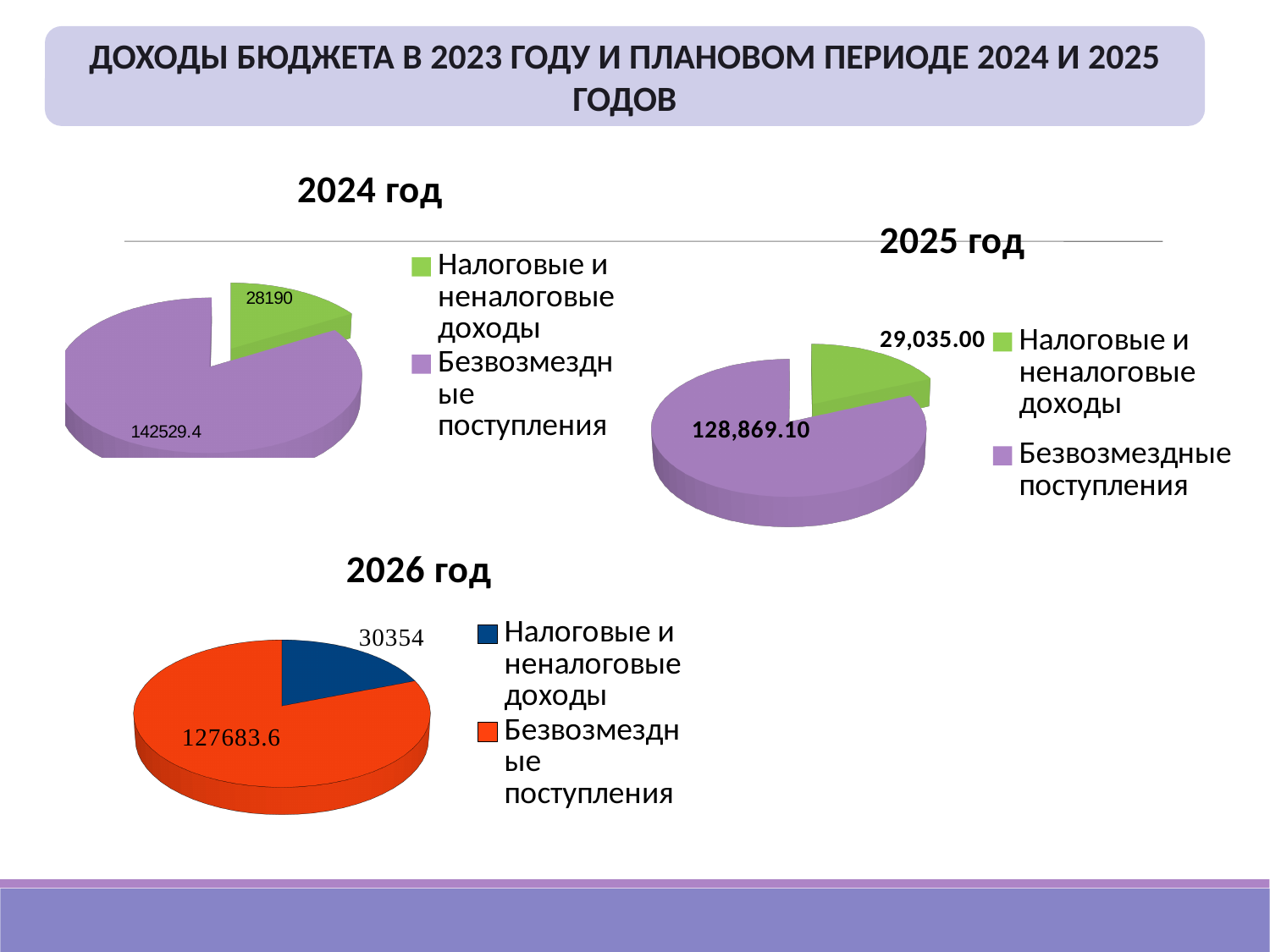
In the "2025 год" chart, which category is the smallest? Налоговые и неналоговые доходы What kind of chart is the "2024 год" chart? pie chart In the "2024 год" chart, what is the total of the two slices? 170719.4 In the "2026 год" chart, what is the value for Безвозмездные поступления? 127683.6 In the "2024 год" chart, what is the value for Налоговые и неналоговые доходы? 28190 In the "2026 год" chart, which category is the largest? Безвозмездные поступления In the "2026 год" chart, what is the difference between Безвозмездные поступления and Налоговые и неналоговые доходы? 97329.6 In the "2025 год" chart, what is the value for Безвозмездные поступления? 128,869.10 How many slices does the "2025 год" chart have? 2 In the "2024 год" chart, what is the value for Безвозмездные поступления? 142529.4 In the "2025 год" chart, what is the value for Налоговые и неналоговые доходы? 29,035.00 In the "2026 год" chart, what colour is the Безвозмездные поступления slice? red